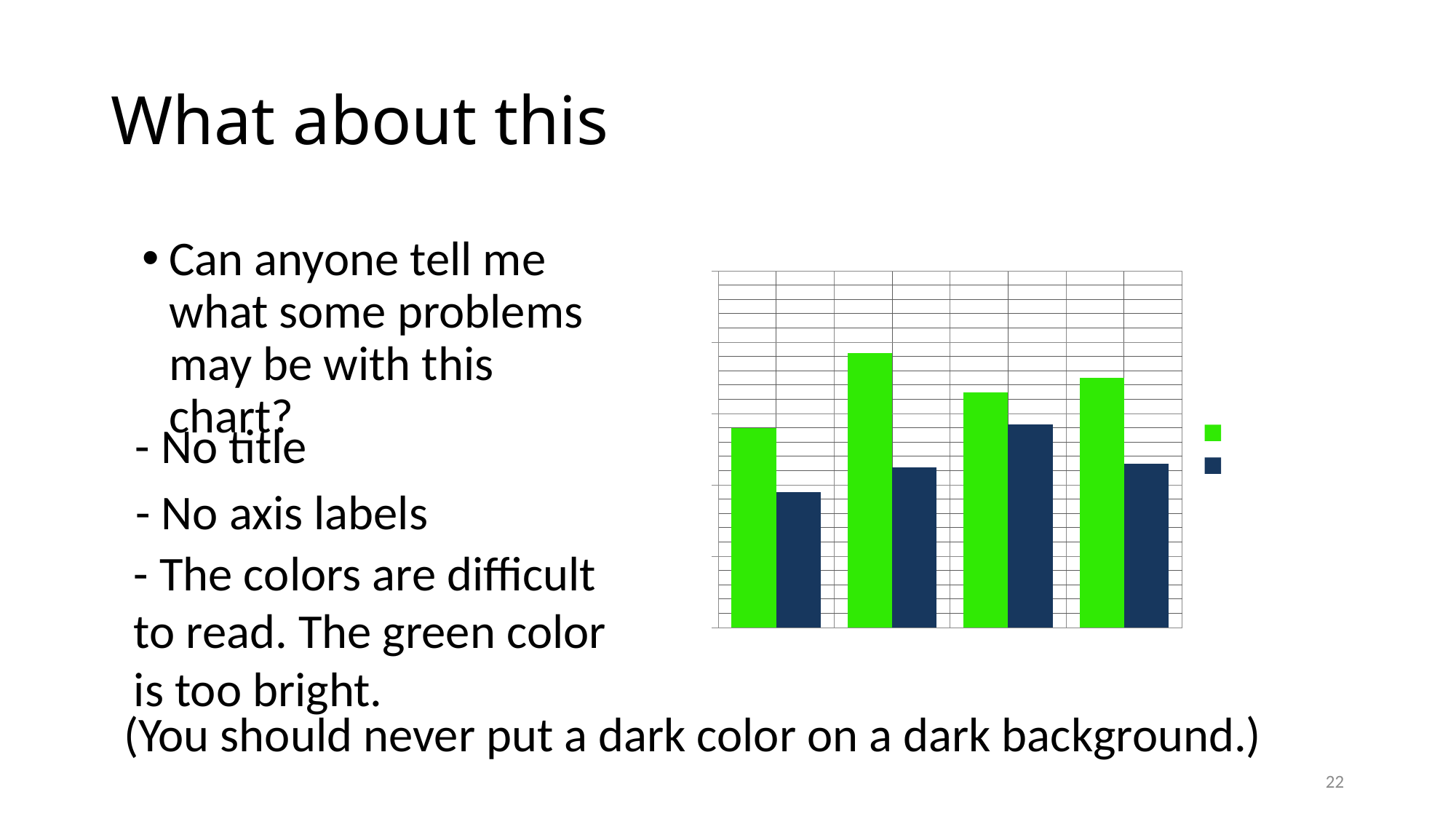
Which group of bars, counting from the left, has the shortest dark blue bar? first How many groups of bars does the chart show? 4 What kind of chart is shown on the slide? bar chart Which group of bars, counting from the left, has the tallest dark blue bar? third Which group of bars, counting from the left, has the tallest green bar? second In the leftmost group of bars, which bar is taller, the green one or the dark blue one? green Does the chart have a title? No What two colours are used for the bars in the chart? green and dark blue Which group of bars, counting from the left, has the shortest green bar? first How many series does the chart's legend list? 2 In the rightmost group of bars, which bar is taller, the green one or the dark blue one? green